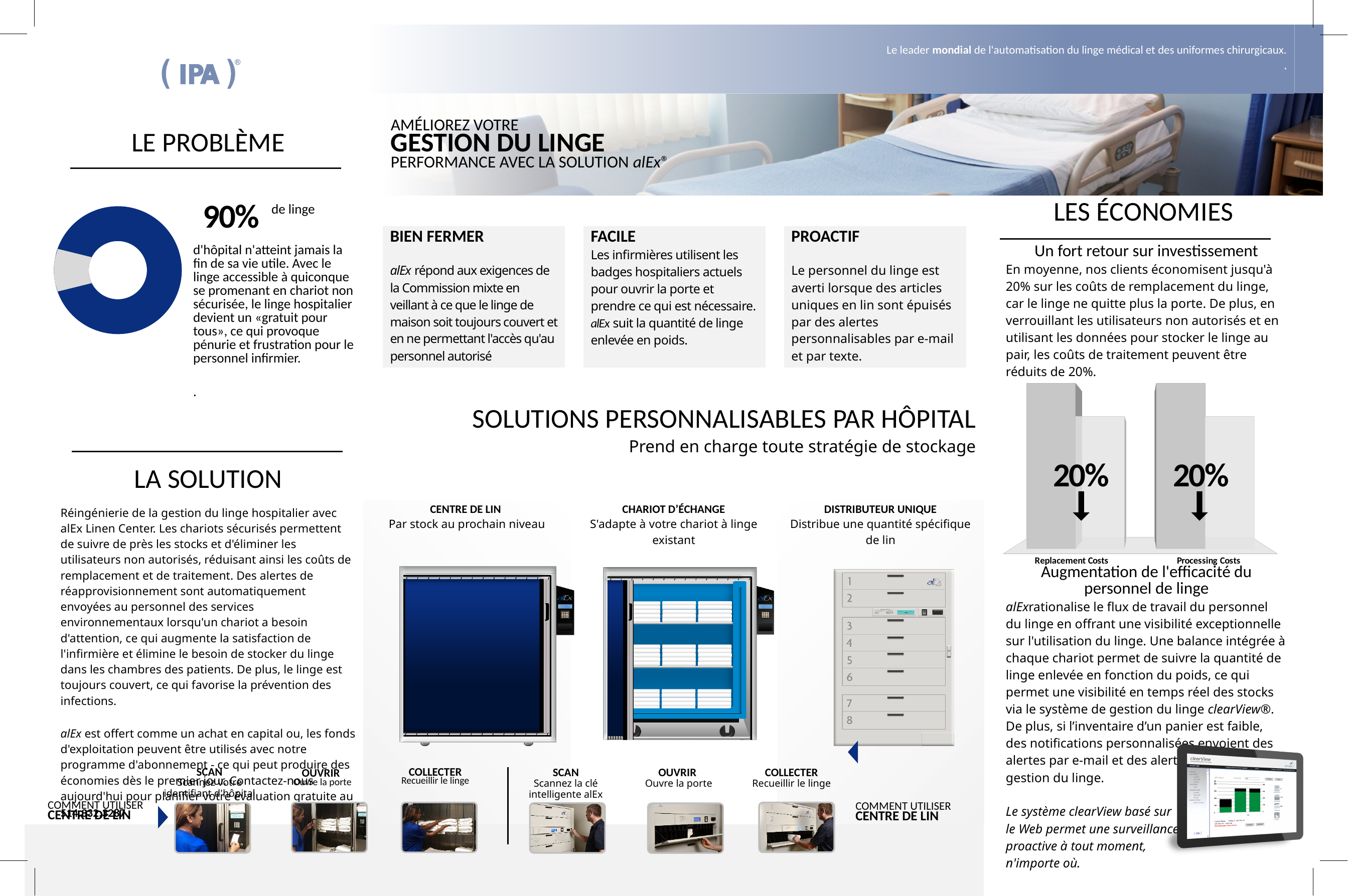
In the donut chart under LE PROBLÈME, what percentage is printed next to the chart for the large blue slice? 90% In the donut chart under LE PROBLÈME, which slice is larger, the blue one or the grey one? The blue one What kind of chart is shown under the heading LES ÉCONOMIES on the right of the slide? Bar chart In the bar chart under LES ÉCONOMIES, which direction do the arrows printed on the bars point? Downward In the bar chart under LES ÉCONOMIES, what value is printed on the Replacement Costs bar? 20% In the bar chart under LES ÉCONOMIES, what is the difference between the Replacement Costs value and the Processing Costs value? 0% What kind of chart is shown under the heading LE PROBLÈME on the left of the slide? Donut chart How many slices does the donut chart under LE PROBLÈME have? 2 In the bar chart under LES ÉCONOMIES, what value is printed on the Processing Costs bar? 20% How many bars does the bar chart under LES ÉCONOMIES have? 4 What are the two category labels under the bars in the bar chart under LES ÉCONOMIES? Replacement Costs and Processing Costs